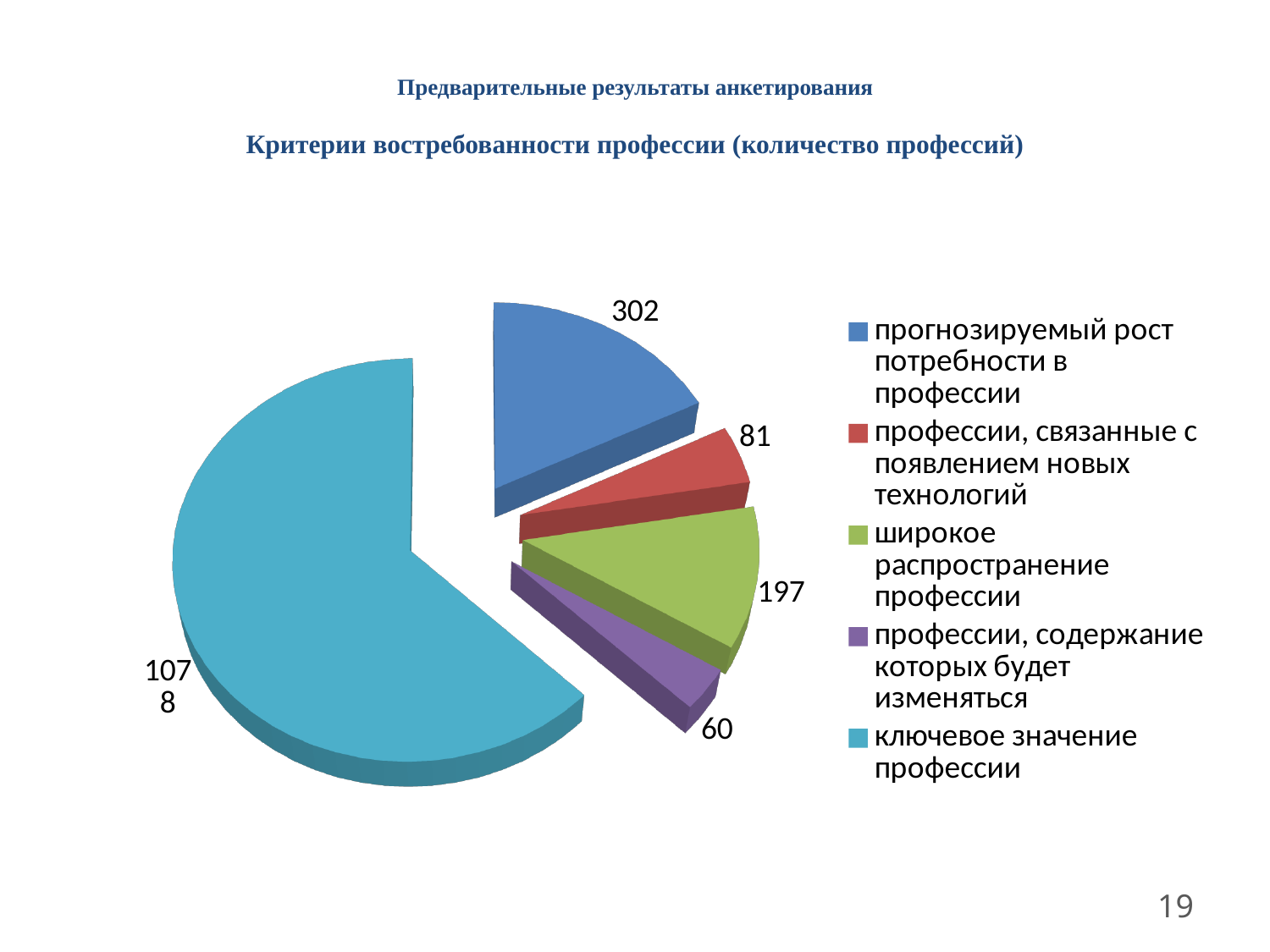
What is the difference between the values for "прогнозируемый рост потребности в профессии" and "профессии, связанные с появлением новых технологий"? 221 Which category has the largest slice of the pie? ключевое значение профессии What colour is the slice for "ключевое значение профессии"? light blue (cyan) Which is larger: the value for "прогнозируемый рост потребности в профессии" or the value for "широкое распространение профессии"? прогнозируемый рост потребности в профессии What is the value for "широкое распространение профессии"? 197 What is the value for "прогнозируемый рост потребности в профессии"? 302 Which category has the smallest slice of the pie? профессии, содержание которых будет изменяться What kind of chart is shown on the slide? pie chart What is the value for "профессии, содержание которых будет изменяться"? 60 What is the value for "профессии, связанные с появлением новых технологий"? 81 How many categories does the pie chart have? 5 What is the value for "ключевое значение профессии"? 1078